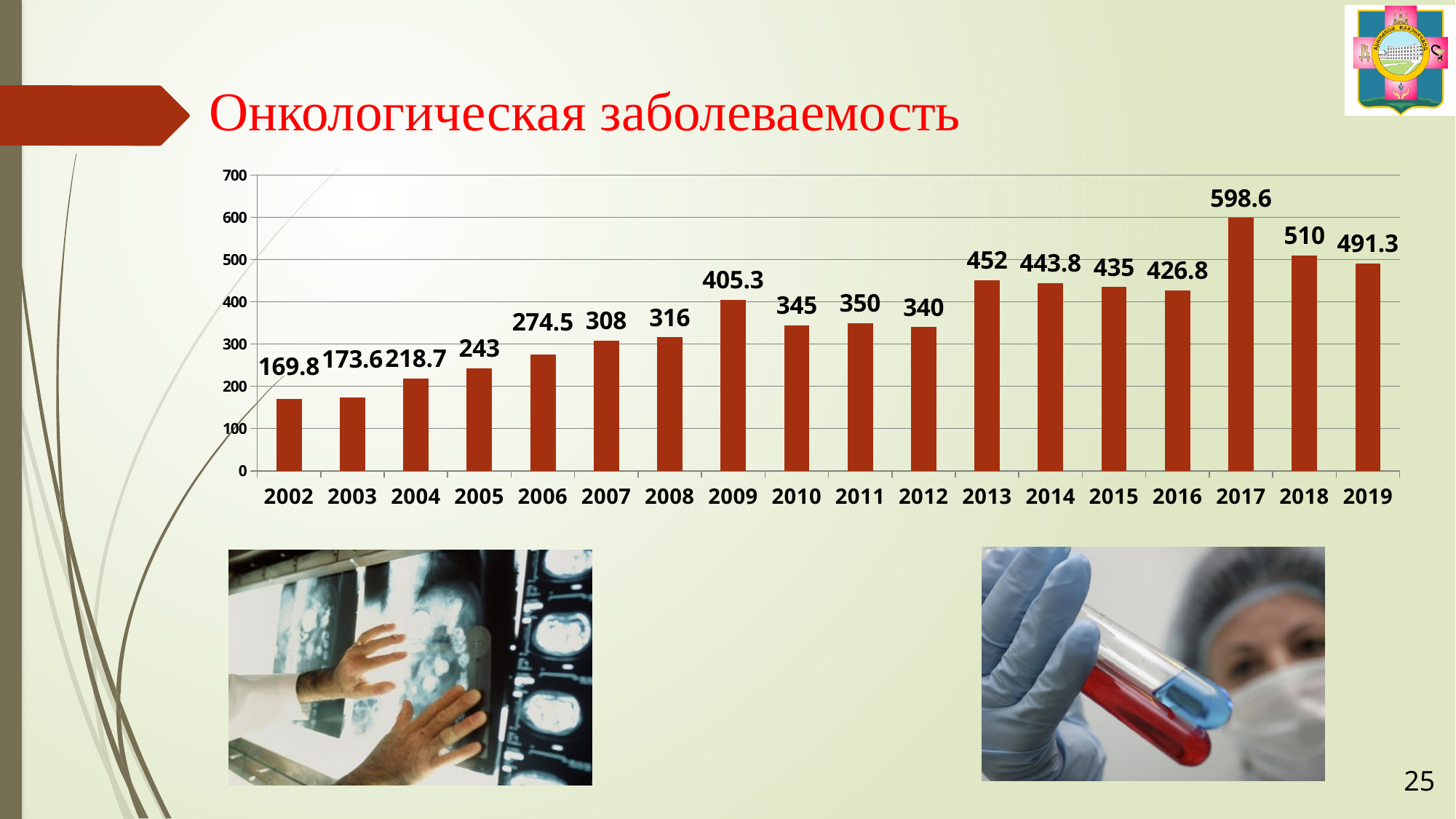
Is the value for 2013 greater or less than 400? greater Which year has the lowest value? 2002 What is the difference between the values for 2017 and 2016? 171.8 Which year has the highest value? 2017 Which is larger, the value for 2011 or the value for 2012? 2011 What is the title of the slide? Онкологическая заболеваемость What is the difference between the values for 2018 and 2019? 18.7 What is the value for 2009? 405.3 How many years are shown on the x axis? 18 What is the value for 2002? 169.8 What kind of chart is shown on the slide? bar chart What is the value for 2017? 598.6